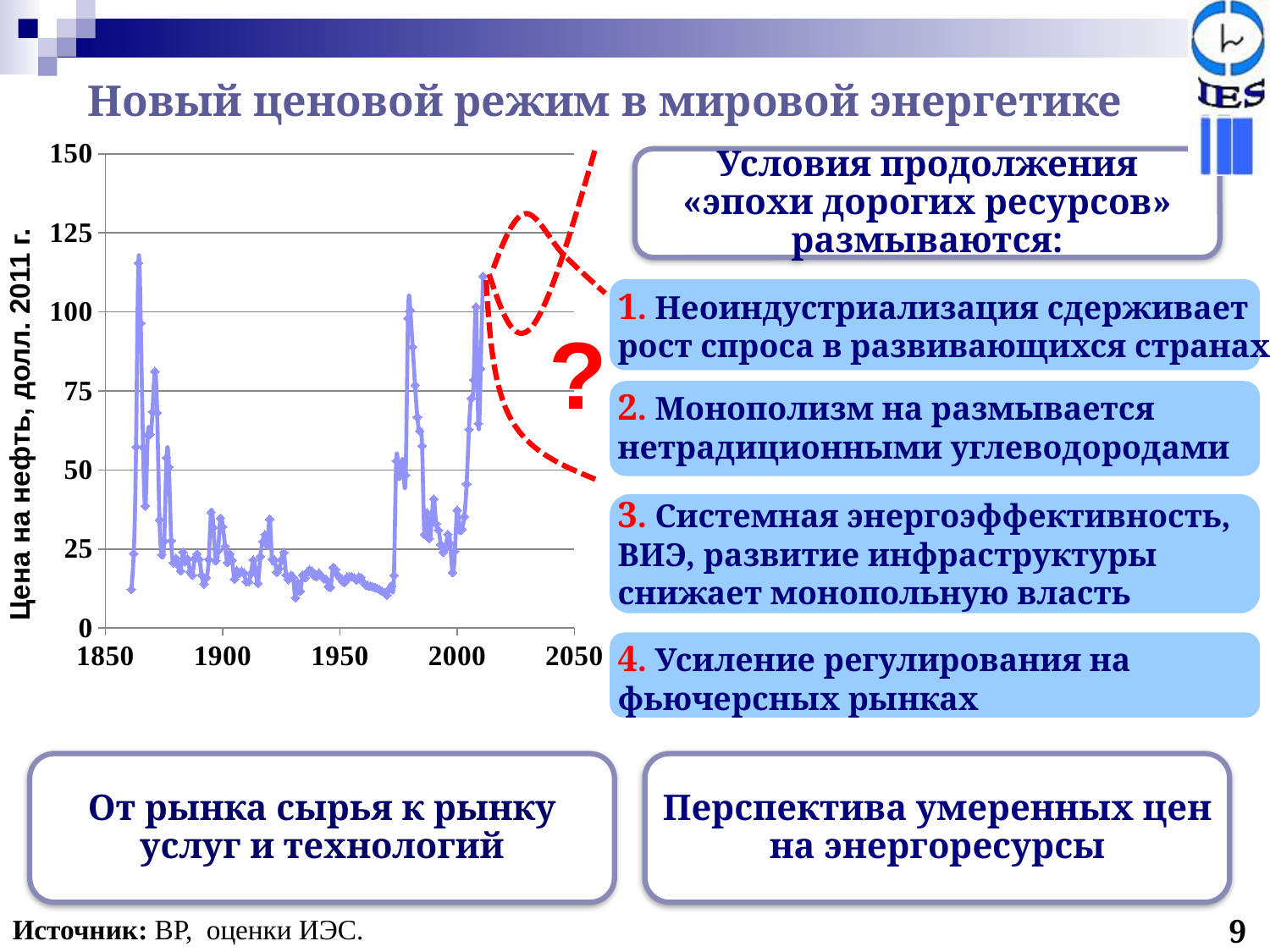
Do the oil price values rise or fall between 1980 and 1990? fall What kind of chart is shown on the slide? line chart What is the last year shown on the horizontal axis of the chart? 2050 Is the oil price value around 1950 greater or less than 25? less What is the label of the vertical axis of the chart? Цена на нефть, долл. 2011 г. How many tick labels are shown on the vertical axis of the chart? 7 What is the first year shown on the horizontal axis of the chart? 1850 What is the highest value shown on the vertical axis of the chart? 150 Which is larger: the oil price value around 1950 or around 1980? around 1980 Is the oil price value around 1980 greater or less than 75? greater Is the peak oil price value around 1865 greater or less than 100? greater